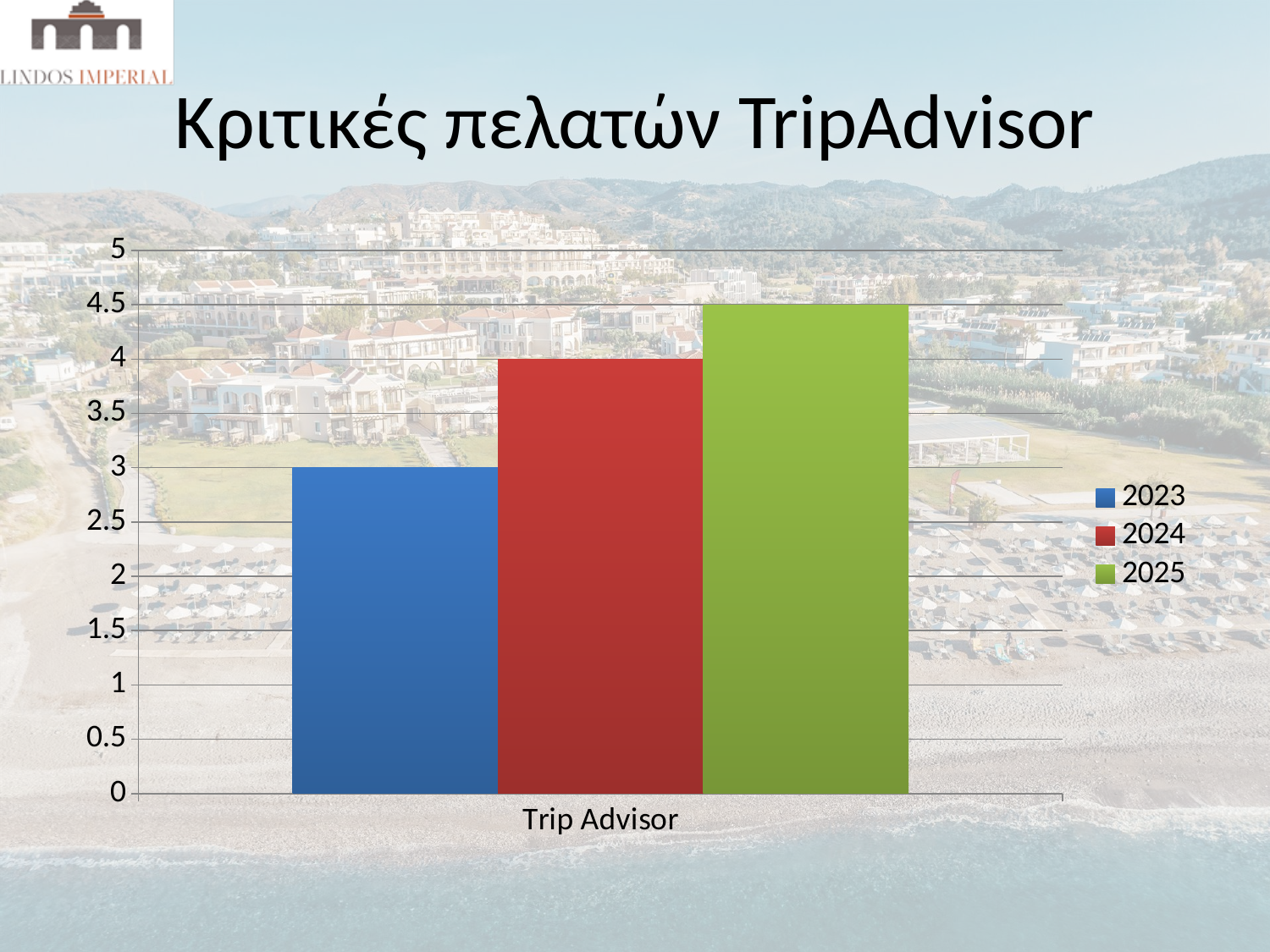
Do the values rise or fall from 2023 to 2025? rise What is the difference between the 2024 and 2023 values? 1 Which year has the highest value? 2025 What is the title of the slide containing the chart? Κριτικές πελατών TripAdvisor What is the difference between the 2025 and 2023 values? 1.5 What kind of chart is shown on the slide? bar chart What is the value for 2025 in the Trip Advisor category? 4.5 What is the value for 2023 in the Trip Advisor category? 3 How many series does the legend list? 3 Which year has the lowest value? 2023 What is the value for 2024 in the Trip Advisor category? 4 Which is larger, the value for 2024 or the value for 2025? 2025